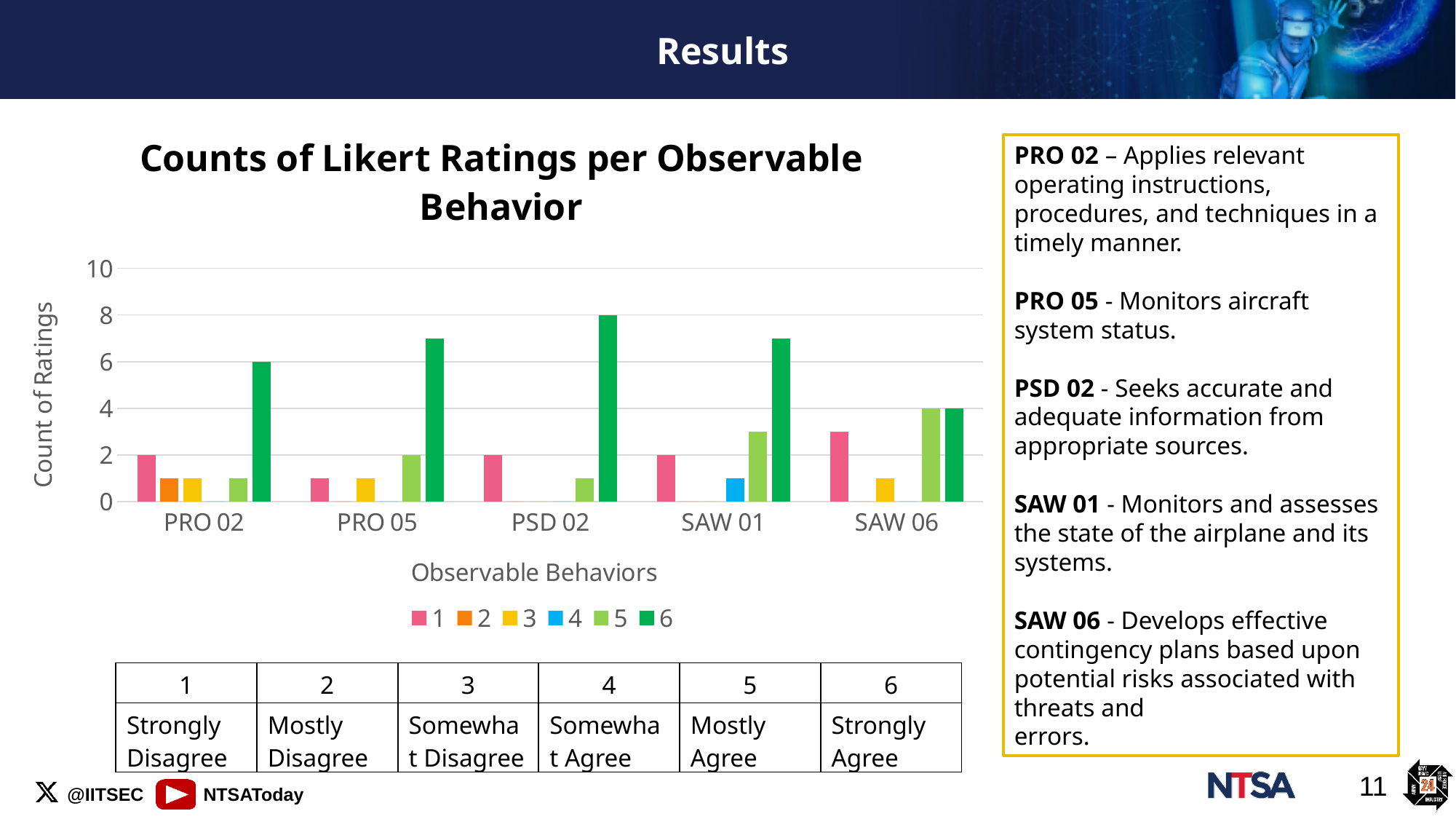
What is the difference between the series 6 count for PSD 02 and the series 6 count for PRO 02? 2 Is the series 6 (Strongly Agree) count for PRO 05 greater or less than 6? greater What is the title of the chart? Counts of Likert Ratings per Observable Behavior How many series does the legend list? 6 Is the series 1 (Strongly Disagree) count for SAW 06 greater or less than 2? greater What is the count of ratings for series 1 (Strongly Disagree) for PRO 02? 2 What is the count of ratings for series 6 (Strongly Agree) for PRO 02? 6 What is the count of ratings for series 5 (Mostly Agree) for SAW 06? 4 What is the count of ratings for series 6 (Strongly Agree) for PSD 02? 8 What type of chart is shown on the slide? bar chart How many observable behaviors (categories) are shown on the x axis? 5 Which observable behavior has the highest count for series 6 (Strongly Agree)? PSD 02